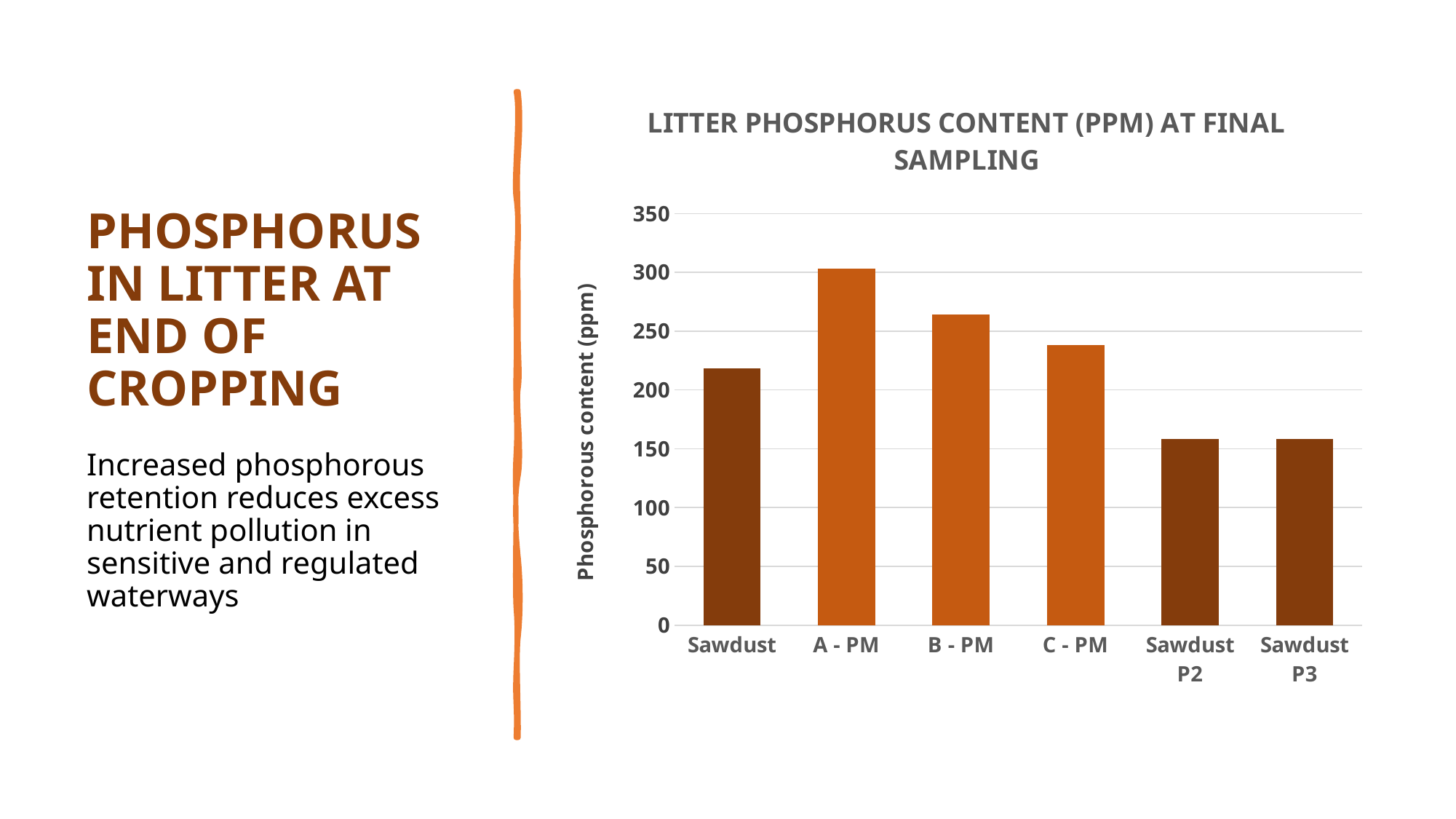
Is the value for B - PM greater or less than 250? greater Is the value for A - PM greater or less than 350? less What is the label on the y axis of the chart? Phosphorous content (ppm) Which has a higher phosphorus content, Sawdust or Sawdust P3? Sawdust What kind of chart is shown on the slide? Bar chart How many categories are shown on the x axis of the chart? 6 Is the value for Sawdust greater or less than 200? greater Which has a higher phosphorus content, B - PM or C - PM? B - PM Which category has the highest litter phosphorus content? A - PM Do the values rise or fall from A - PM to C - PM? fall